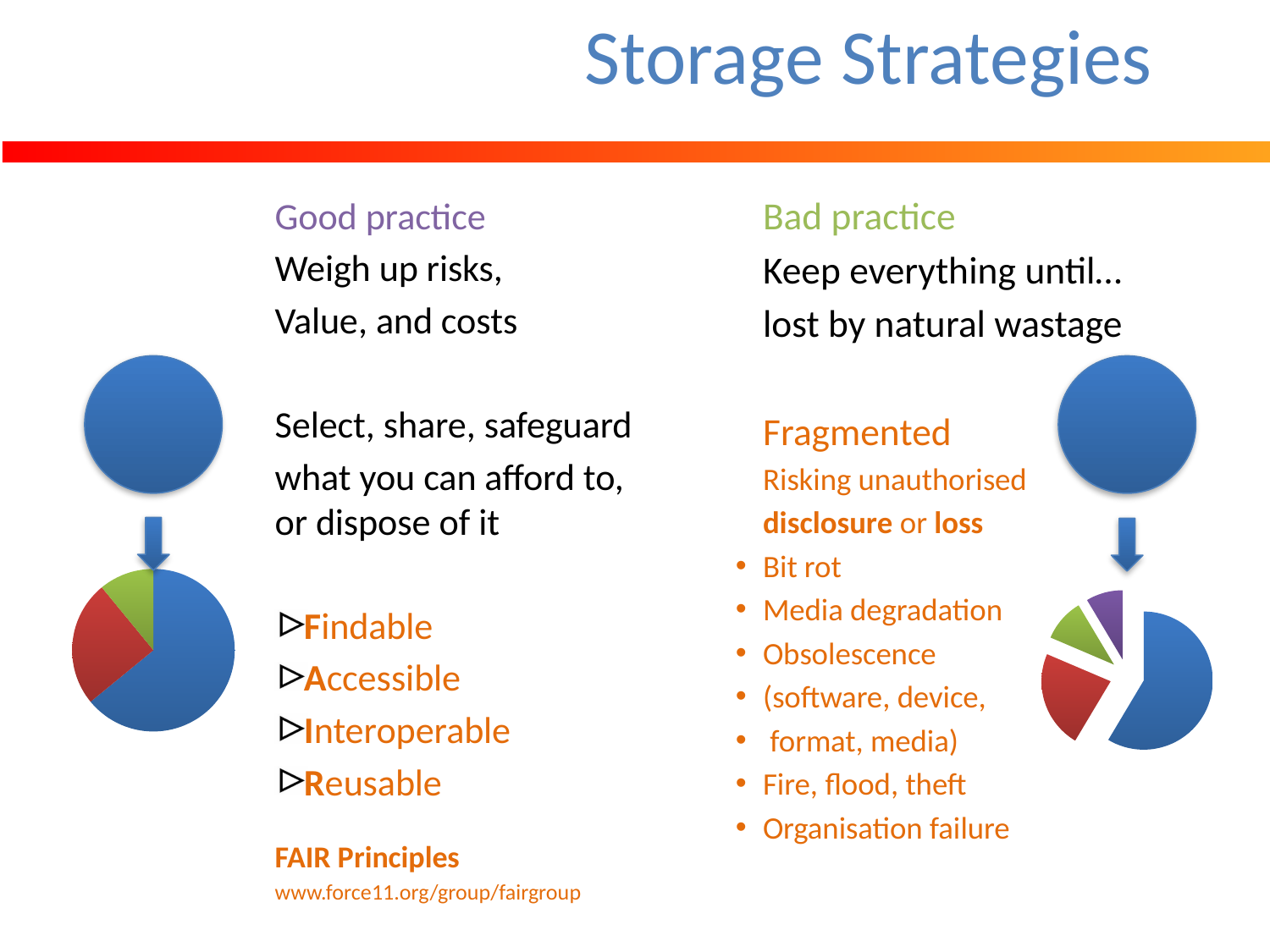
In the pie chart on the left side of the slide, which colour slice is the smallest? green What kind of chart is shown on the right side of the slide, under the 'Bad practice' heading? pie chart In the pie chart on the right side of the slide, which colour slice is the smallest? purple In the pie chart on the left side of the slide, which colour slice is the largest? blue In the pie chart on the right side of the slide, which colour slice is the largest? blue How many slices does the pie chart on the right side of the slide have? 4 What kind of chart is shown on the left side of the slide, under the 'Good practice' heading? pie chart In the pie chart on the right side of the slide, which is larger, the red slice or the green slice? red How many slices does the pie chart on the left side of the slide have? 3 In the pie chart on the left side of the slide, which is larger, the red slice or the green slice? red Which of the two pie charts on the slide has its slices pulled apart (exploded)? the right one Does either pie chart on the slide show a legend? No